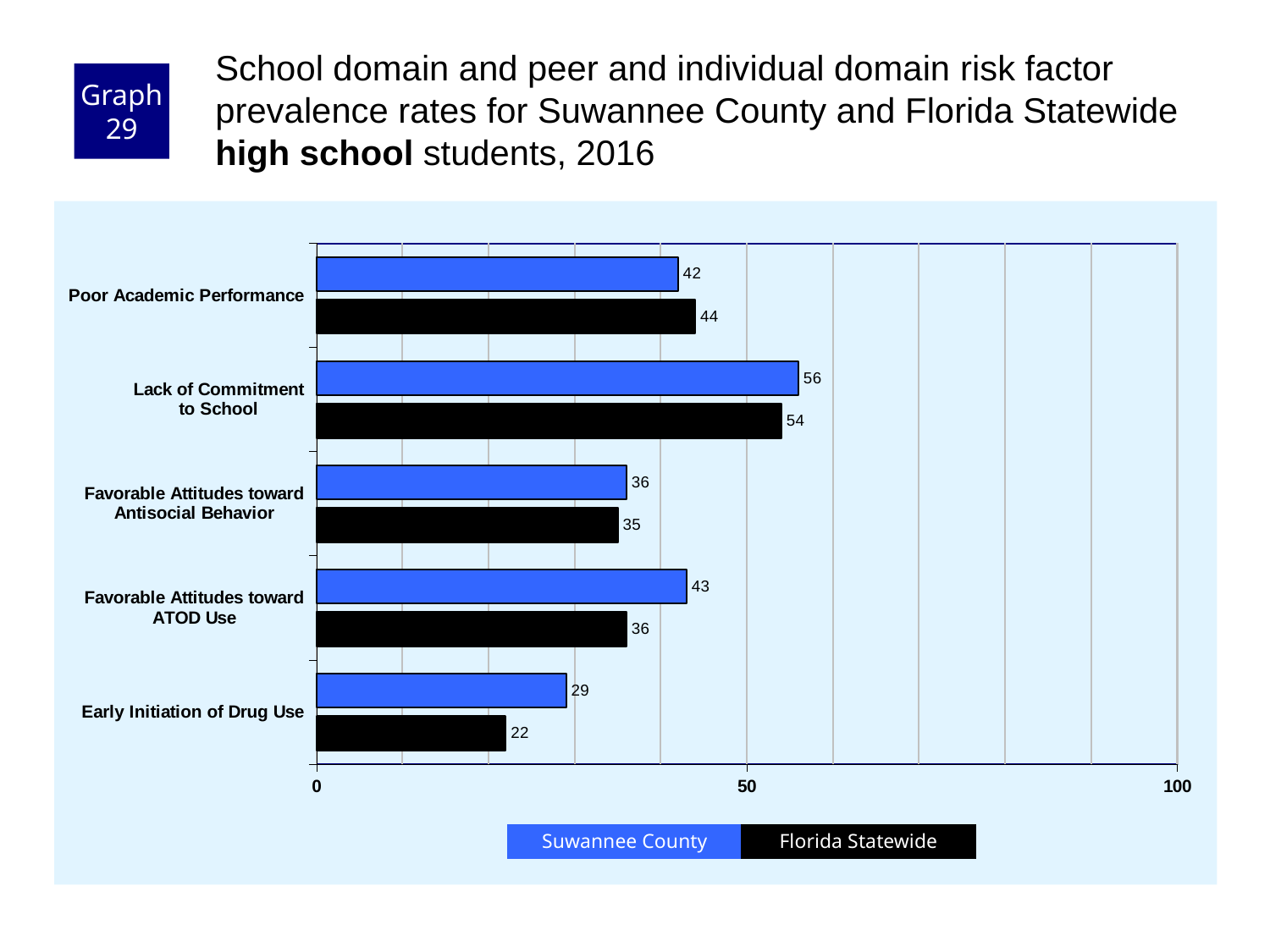
Is the Suwannee County value for Lack of Commitment to School greater or less than 50? greater What is the Florida Statewide value for Early Initiation of Drug Use? 22 What is the Florida Statewide value for Favorable Attitudes toward ATOD Use? 36 Which risk factor has the highest Suwannee County value? Lack of Commitment to School For Poor Academic Performance, which is larger: the Suwannee County value or the Florida Statewide value? Florida Statewide How many risk factors are shown on the chart? 5 What is the difference between the Suwannee County and Florida Statewide values for Early Initiation of Drug Use? 7 What kind of chart is shown on the slide? Bar chart What is the difference between the Suwannee County and Florida Statewide values for Favorable Attitudes toward ATOD Use? 7 What is the Suwannee County value for Lack of Commitment to School? 56 Which risk factor has the lowest Florida Statewide value? Early Initiation of Drug Use How many series does the legend list? 2